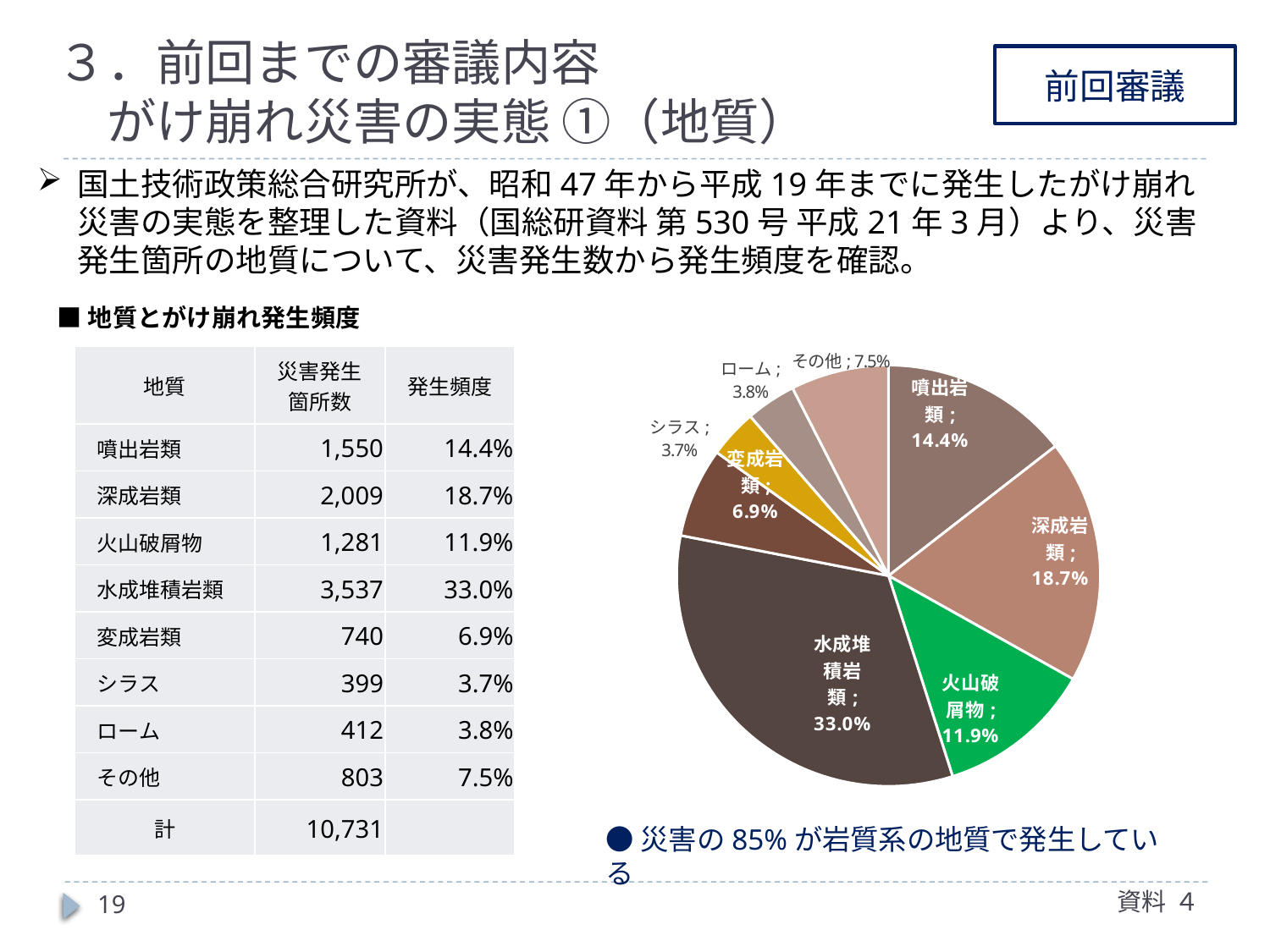
What colour is the 火山破屑物 slice in the pie chart? green In the pie chart, what is the difference in percentage points between 水成堆積岩類 and 深成岩類? 14.3 What percentage does the pie chart show for 変成岩類? 6.9% What percentage does the pie chart show for 深成岩類? 18.7% In the pie chart, what is the difference in percentage points between 深成岩類 and 噴出岩類? 4.3 In the pie chart, which is larger, 噴出岩類 or 火山破屑物? 噴出岩類 Which category has the largest slice in the pie chart? 水成堆積岩類 What percentage does the pie chart show for その他? 7.5% What percentage does the pie chart show for 水成堆積岩類? 33.0% What kind of chart is shown on the slide? pie chart How many slices does the pie chart have? 8 What percentage does the pie chart show for 火山破屑物? 11.9%